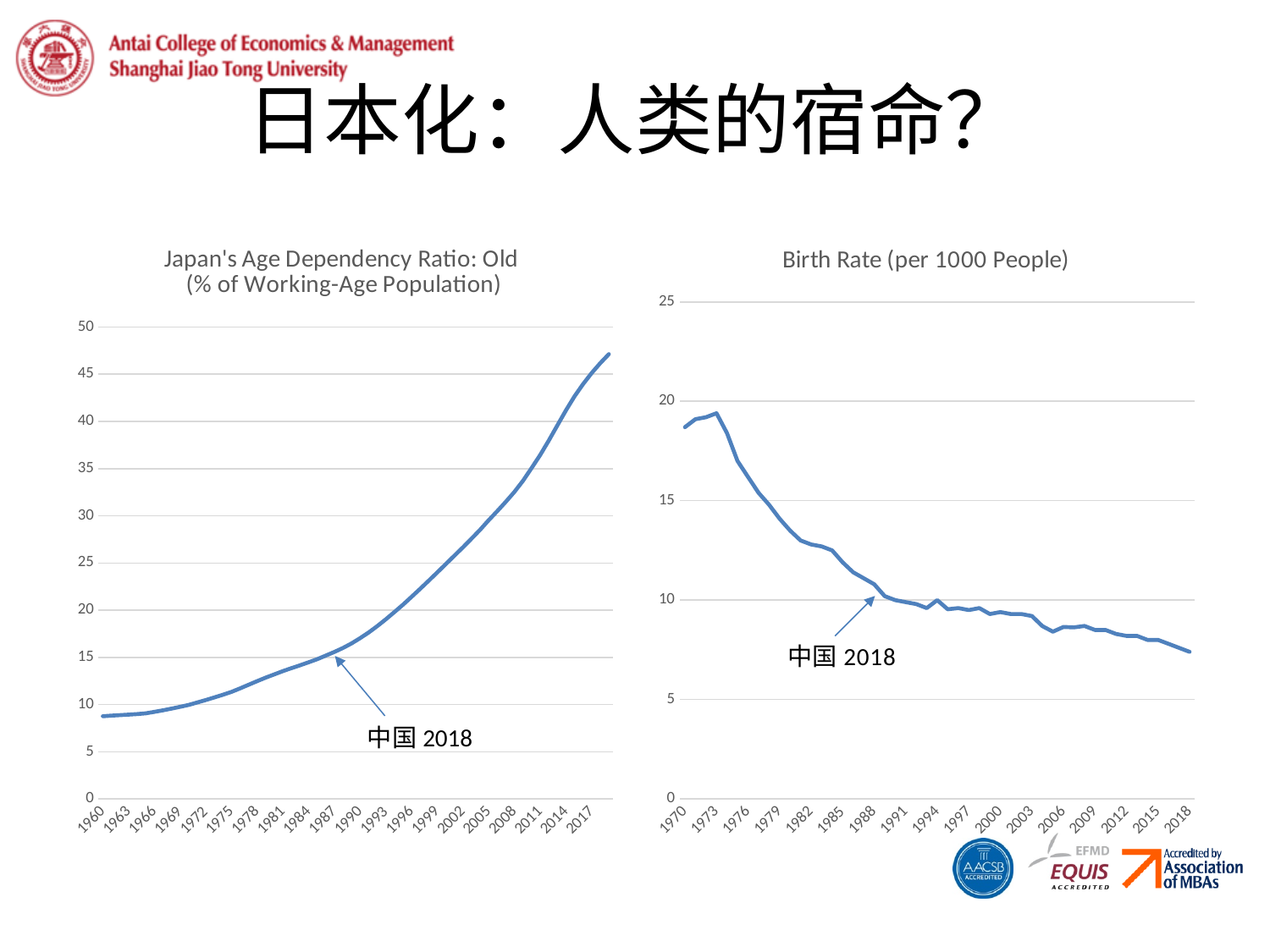
In the right chart, "Birth Rate (per 1000 People)", is the value for 1970 greater or less than 20? less In the right chart, "Birth Rate (per 1000 People)", do the values generally rise or fall from 1973 to 2018? fall In the right chart, "Birth Rate (per 1000 People)", which year has the lowest value? 2018 In the left chart, "Japan's Age Dependency Ratio: Old", do the values rise or fall from 1960 to 2017? rise In the right chart, "Birth Rate (per 1000 People)", is the value for 1982 greater or less than 10? greater What kind of chart is the right chart, "Birth Rate (per 1000 People)"? line chart What is the title of the right chart? Birth Rate (per 1000 People) In the left chart, "Japan's Age Dependency Ratio: Old", is the value for 1960 greater or less than 10? less What kind of chart is the left chart, "Japan's Age Dependency Ratio: Old"? line chart